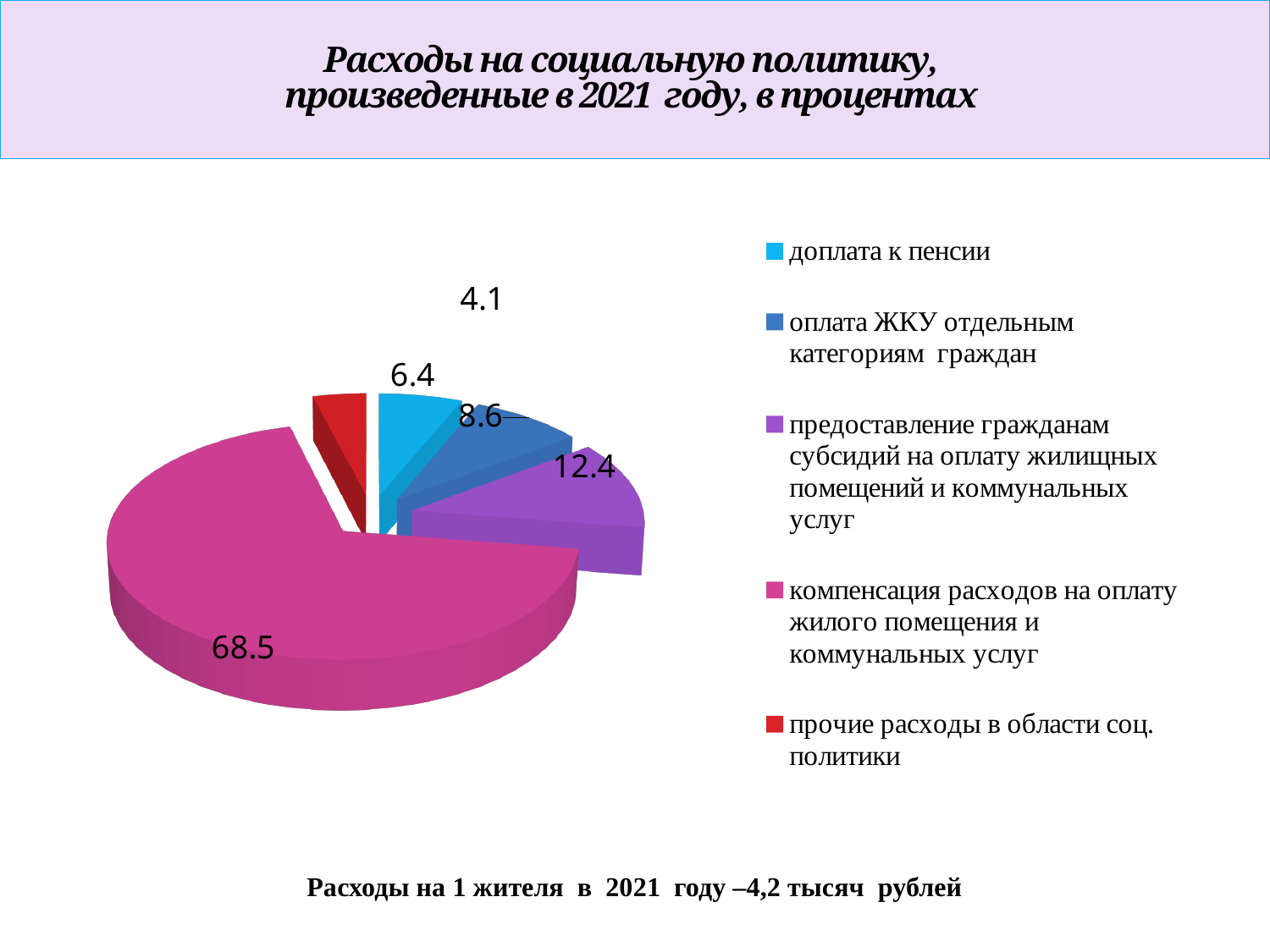
What colour is the largest slice of the pie? pink What is the difference between the values for компенсация расходов на оплату жилого помещения и коммунальных услуг and предоставление гражданам субсидий? 56.1 What is the difference between the values for предоставление гражданам субсидий and оплата ЖКУ отдельным категориям граждан? 3.8 What is the value for предоставление гражданам субсидий на оплату жилищных помещений и коммунальных услуг? 12.4 What is the title of the chart? Расходы на социальную политику, произведенные в 2021 году, в процентах What is the smallest value labelled on the pie chart? 4.1 What kind of chart is shown on the slide? pie chart Which is larger: предоставление гражданам субсидий or оплата ЖКУ отдельным категориям граждан? предоставление гражданам субсидий What is the value for оплата ЖКУ отдельным категориям граждан? 8.6 What is the value for компенсация расходов на оплату жилого помещения и коммунальных услуг? 68.5 How many slices does the pie chart have? 5 Which category has the largest share of the pie? компенсация расходов на оплату жилого помещения и коммунальных услуг